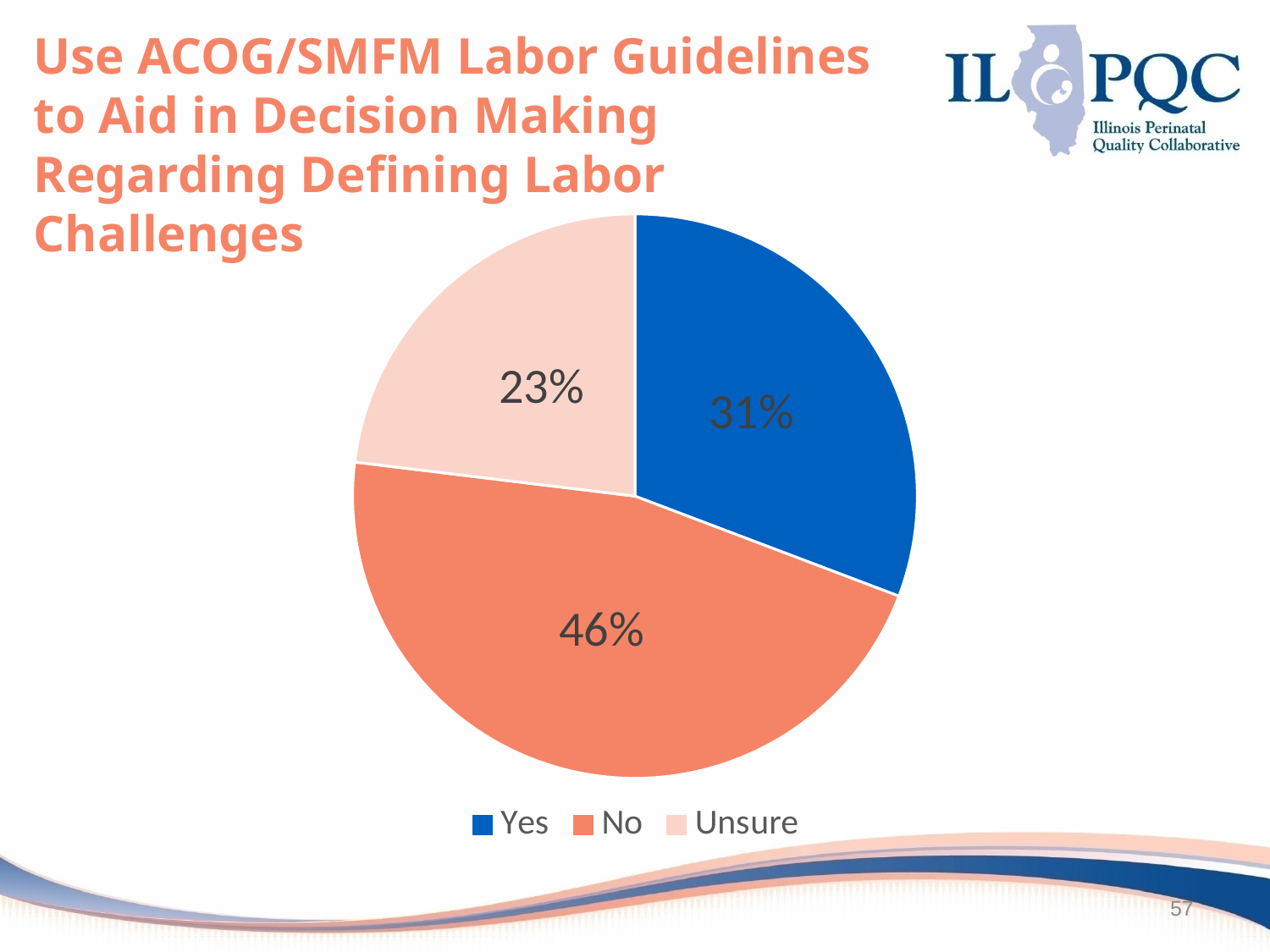
What percentage of the pie is labelled "Yes"? 31% How many entries does the legend list? 3 What kind of chart is shown on the slide? pie chart What colour is the "No" slice in the pie chart? orange Which is larger, the "Yes" slice or the "Unsure" slice? Yes What is the difference in percentage points between the "No" and "Yes" slices? 15 What percentage of the pie is labelled "No"? 46% What percentage of the pie is labelled "Unsure"? 23% Which response has the largest share of the pie? No How many slices does the pie chart have? 3 What is the difference in percentage points between the "Yes" and "Unsure" slices? 8 Which response has the smallest share of the pie? Unsure